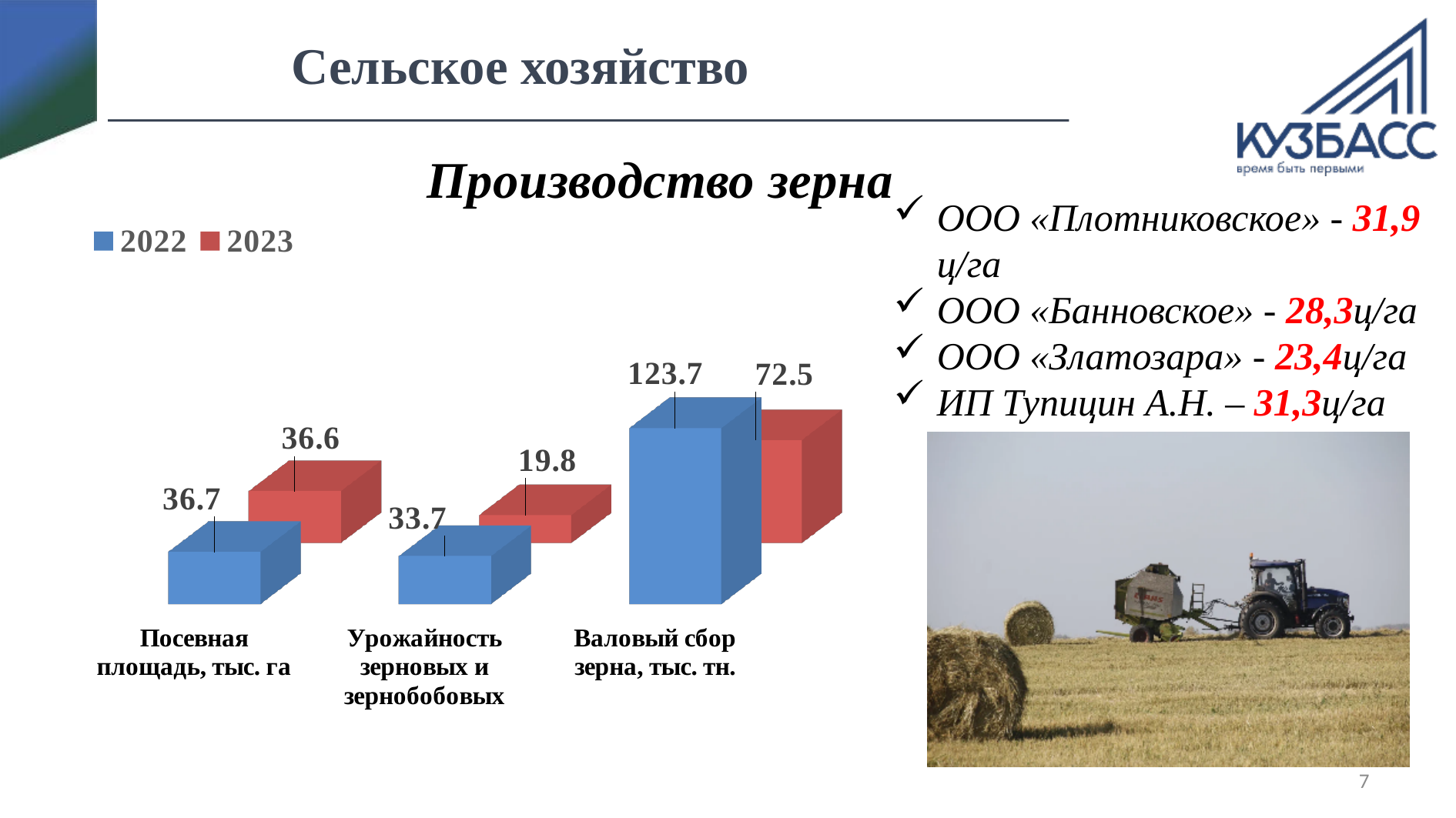
What is the difference between the 2022 and 2023 values for Урожайность зерновых и зернобобовых? 13.9 Which is larger for Урожайность зерновых и зернобобовых: the 2022 value or the 2023 value? 2022 How many categories are shown on the x axis of the chart? 3 How many series does the chart legend list? 2 Which category has the highest 2022 value? Валовый сбор зерна, тыс. тн. What is the 2022 value for Валовый сбор зерна, тыс. тн.? 123.7 What is the 2022 value for Посевная площадь, тыс. га? 36.7 What is the 2023 value for Валовый сбор зерна, тыс. тн.? 72.5 What type of chart is shown on the slide? Bar chart What is the 2023 value for Урожайность зерновых и зернобобовых? 19.8 Which category has the lowest 2023 value? Урожайность зерновых и зернобобовых What is the difference between the 2022 and 2023 values for Валовый сбор зерна, тыс. тн.? 51.2